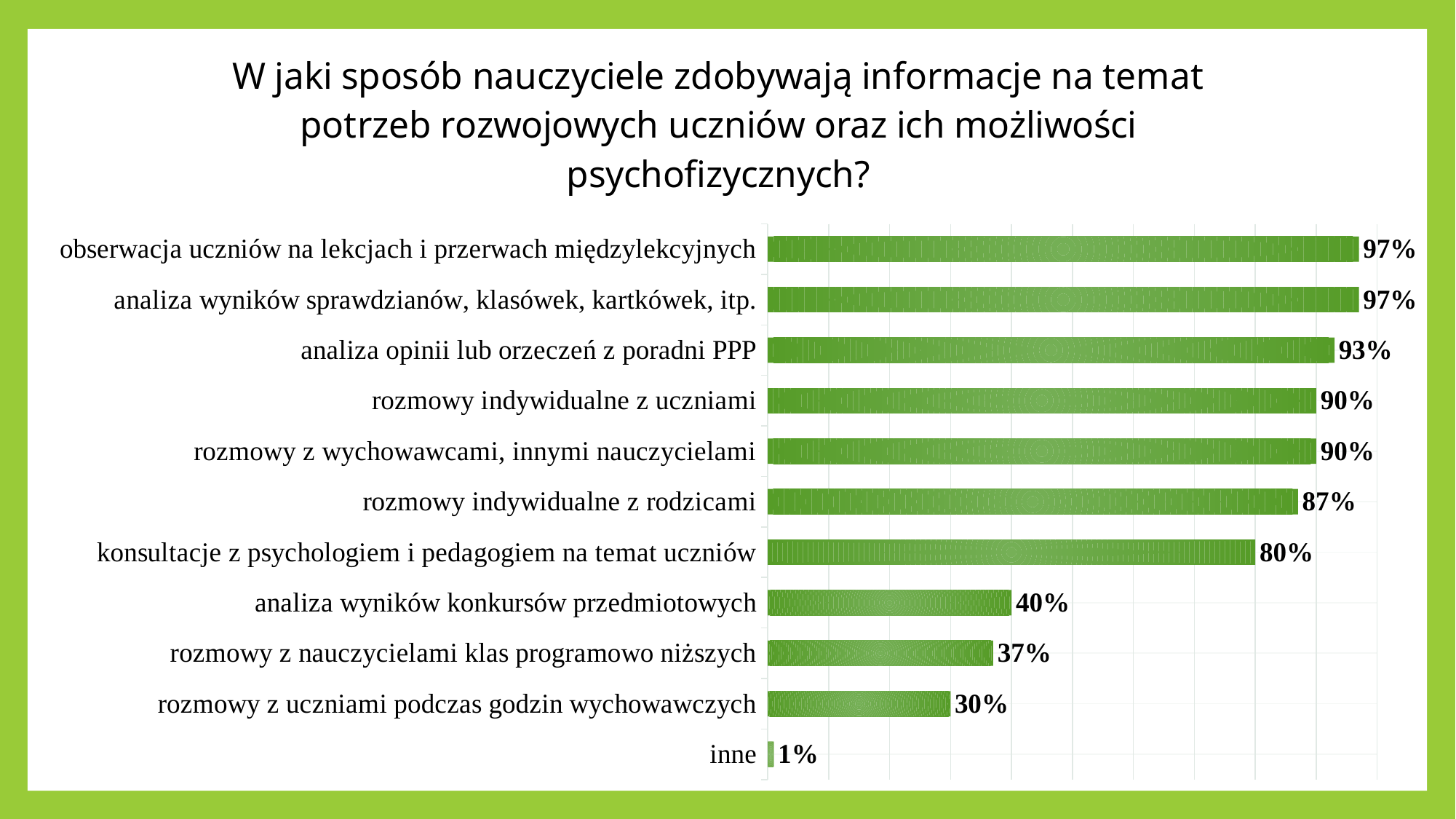
What colour are the bars on the chart? green What is the highest value shown on the chart? 97% What is the difference between the values for "analiza wyników konkursów przedmiotowych" and "rozmowy z nauczycielami klas programowo niższych"? 3% How many categories are shown on the chart? 11 What value is shown for "rozmowy z uczniami podczas godzin wychowawczych"? 30% What value is shown for "analiza opinii lub orzeczeń z poradni PPP"? 93% Which category has the lowest value? inne What is the difference between the values for "rozmowy indywidualne z rodzicami" and "konsultacje z psychologiem i pedagogiem na temat uczniów"? 7% Which is larger: the value for "rozmowy indywidualne z uczniami" or the value for "rozmowy indywidualne z rodzicami"? rozmowy indywidualne z uczniami What value is shown for "konsultacje z psychologiem i pedagogiem na temat uczniów"? 80% What kind of chart is shown on the slide? bar chart What value is shown for "inne"? 1%